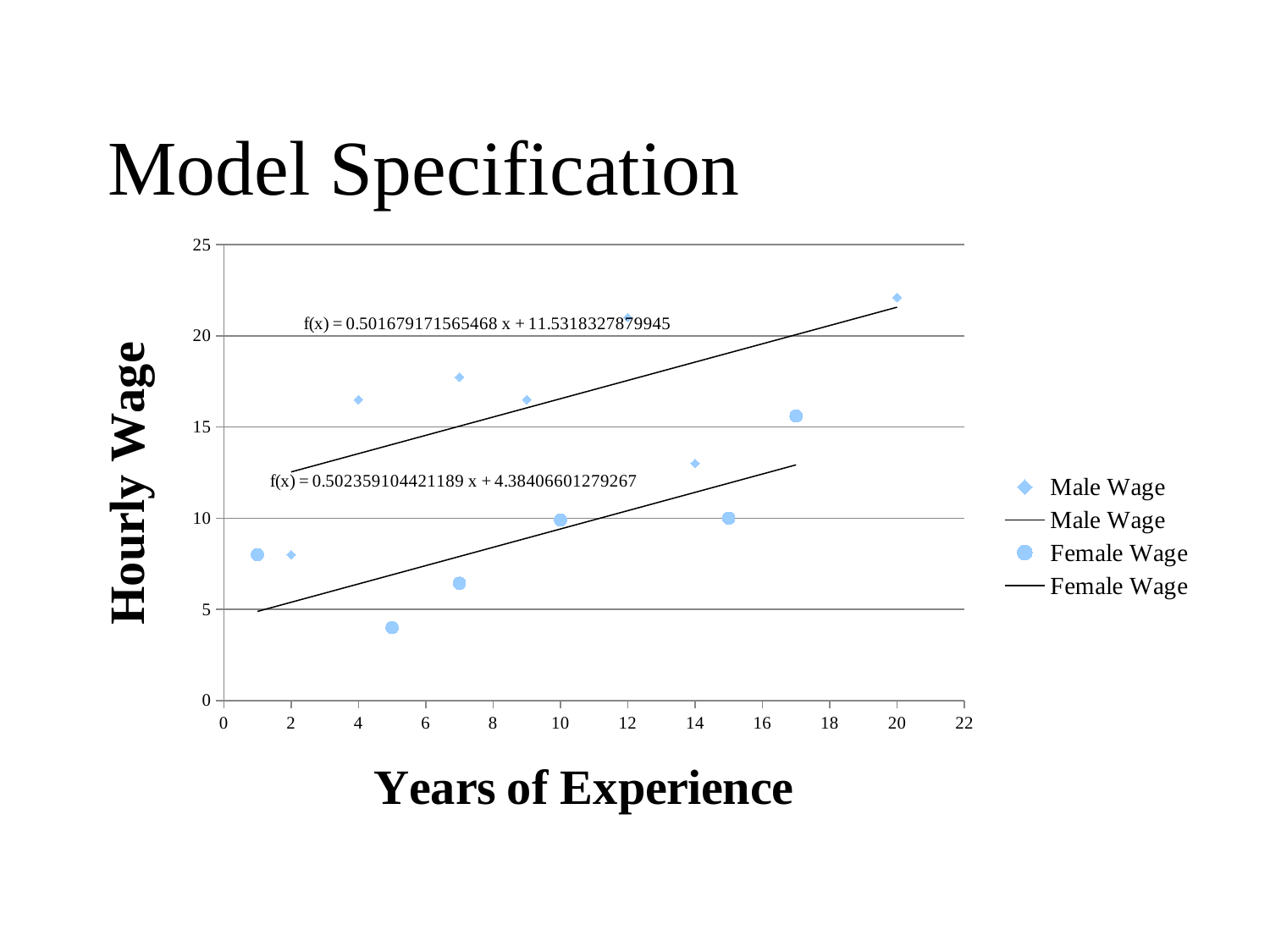
What kind of chart is shown on the slide? scatter chart How many Female Wage data points are plotted? 6 What is the intercept in the lower trendline equation printed on the chart? 4.38406601279267 Is the Female Wage value at 17 years of experience greater or less than 15? greater Which is larger: the Male Wage at 4 years of experience or the Female Wage at 5 years of experience? Male Wage at 4 years Is the Female Wage value at 5 years of experience greater or less than 5? less Is the Male Wage value at 14 years of experience greater or less than 15? less How many Male Wage data points are plotted? 7 Do the Male Wage trendline values rise or fall as years of experience increase? rise What is the title of the x axis? Years of Experience How many entries does the legend list? 4